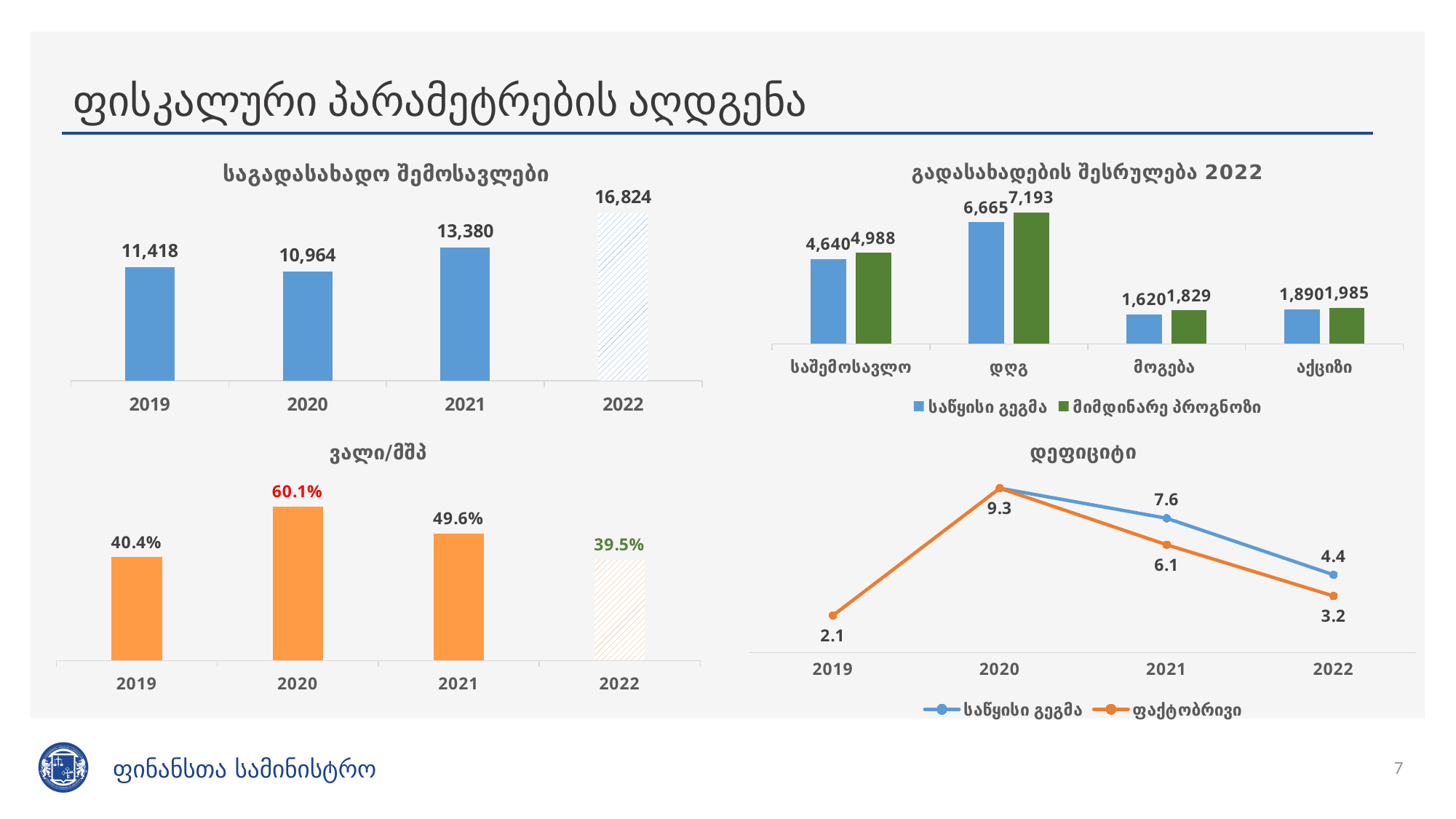
In the top-right chart titled "გადასახადების შესრულება 2022", what is the value of the "მიმდინარე პროგნოზი" series for "დღგ"? 7,193 In the bottom-right chart titled "დეფიციტი", what is the value of the "ფაქტობრივი" series for 2021? 6.1 What kind of chart is the bottom-right chart titled "დეფიციტი"? line chart In the top-left chart titled "საგადასახადო შემოსავლები", what is the value for 2021? 13,380 In the top-left chart titled "საგადასახადო შემოსავლები", which year has the lowest value? 2020 In the top-right chart titled "გადასახადების შესრულება 2022", which category has the highest values? დღგ In the bottom-left chart titled "ვალი/მშპ", what is the value for 2020? 60.1% In the top-right chart titled "გადასახადების შესრულება 2022", how many series does the legend list? 2 In the bottom-right chart titled "დეფიციტი", do the values rise or fall from 2020 to 2022? fall In the bottom-left chart titled "ვალი/მშპ", which year has the lowest value? 2022 In the top-left chart titled "საგადასახადო შემოსავლები", what is the difference between the 2022 and 2021 values? 3,444 In the top-right chart titled "გადასახადების შესრულება 2022", what is the difference between the "მიმდინარე პროგნოზი" and "საწყისი გეგმა" values for "საშემოსავლო"? 348